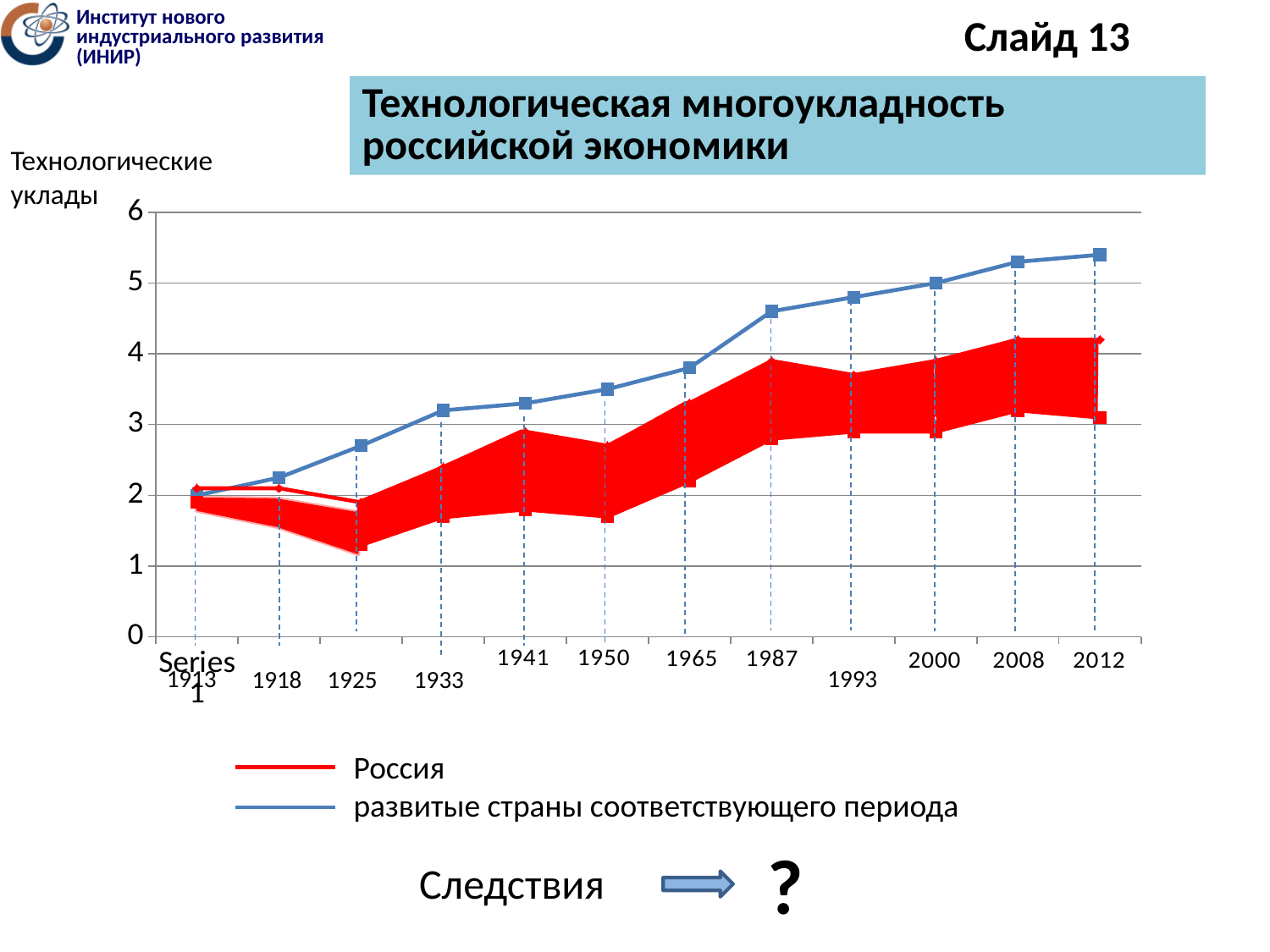
Is the value for развитые страны соответствующего периода in 1925 greater or less than 3? less Is the value for развитые страны соответствующего периода in 2012 greater or less than 5? greater What kind of chart is shown on the slide? line chart In which year is the value for развитые страны соответствующего периода lowest? 1913 How many series does the legend list? 2 Which colour represents Россия in the legend? red Is the value for развитые страны соответствующего периода in 1950 greater or less than 4? less Does the line for развитые страны соответствующего периода rise or fall from 1913 to 2012? rise In 2012, which series has the higher value: Россия or развитые страны соответствующего периода? развитые страны соответствующего периода How many years are labelled along the x axis? 12 In which year is the value for развитые страны соответствующего периода highest? 2012